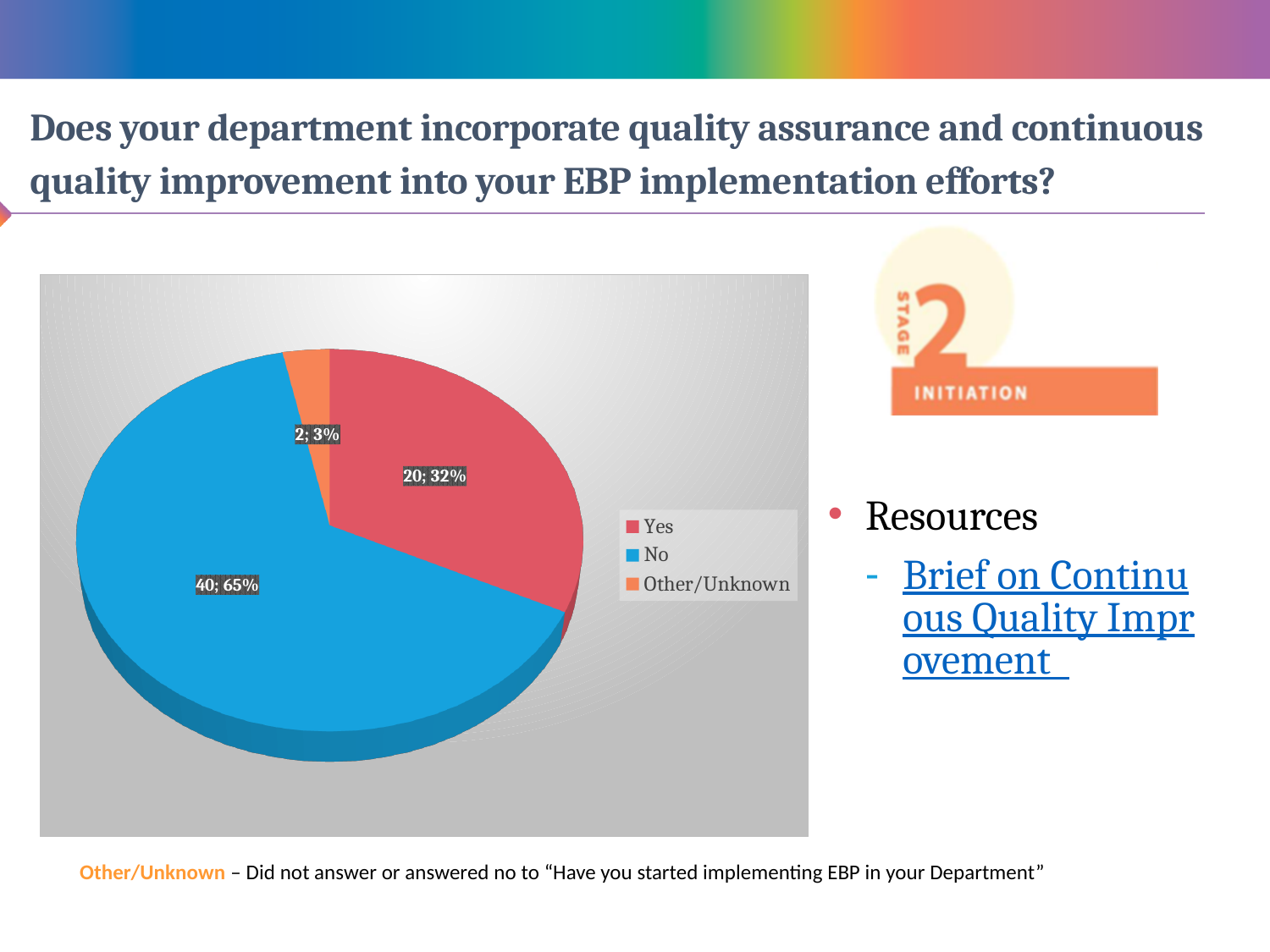
What colour is the 'No' slice in the pie chart? Blue What percentage of the pie does 'Yes' represent? 32% What is the count for the 'No' slice? 40 What is the count for the 'Other/Unknown' slice? 2 What percentage of the pie does 'No' represent? 65% What kind of chart is shown on the slide? Pie chart Which is larger, the 'Yes' slice or the 'Other/Unknown' slice? Yes What is the difference in count between 'No' and 'Yes'? 20 Which category has the largest slice? No Which category has the smallest slice? Other/Unknown What is the total count across all three slices? 62 How many slices does the pie chart have? 3